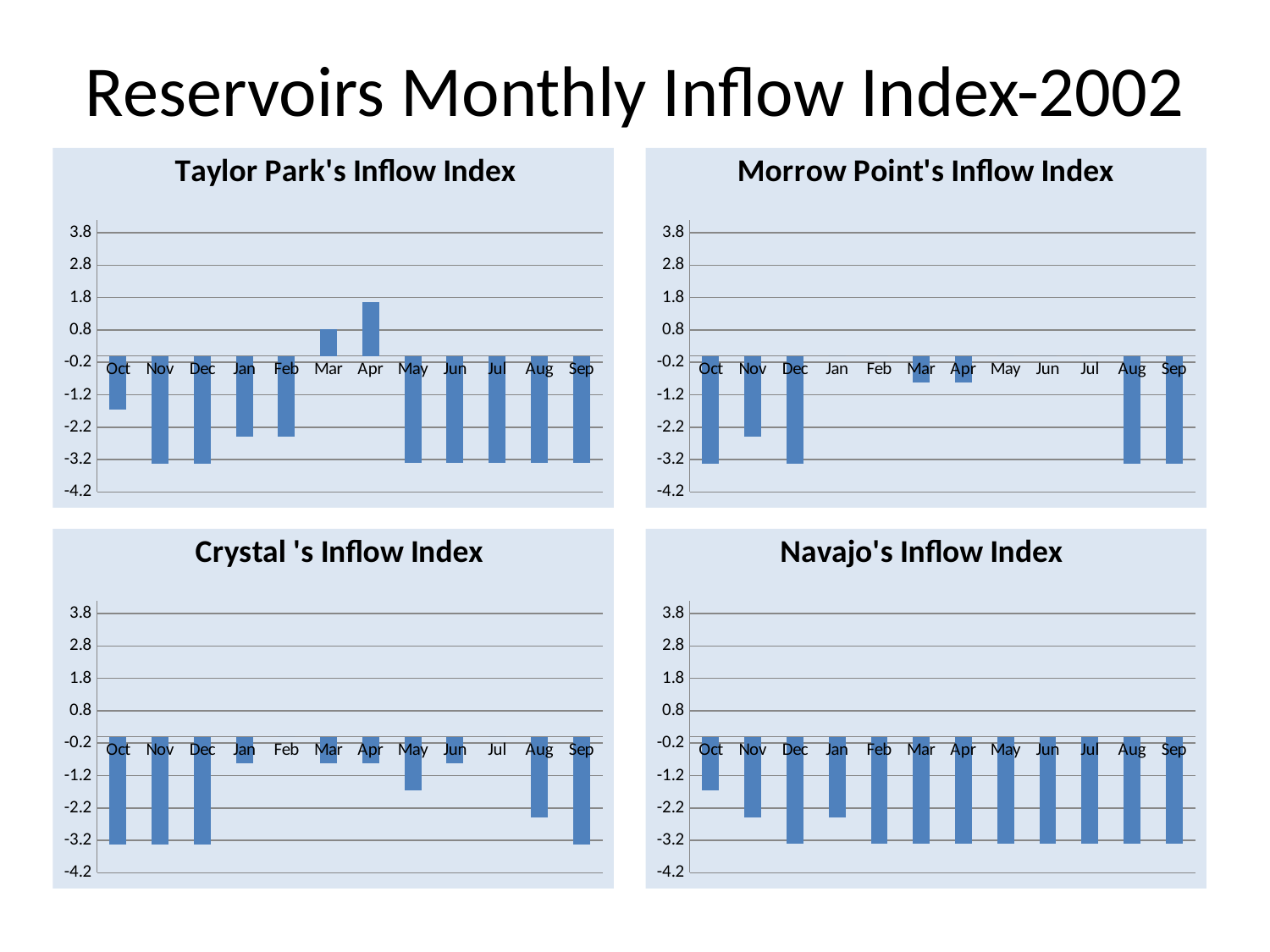
On the Crystal 's Inflow Index chart, which is larger, the value for Jan or the value for Sep? Jan On the Taylor Park's Inflow Index chart, which month has the highest value? Apr How many charts are shown on the slide? 4 On the Navajo's Inflow Index chart, which month has the highest value? Oct On the Taylor Park's Inflow Index chart, is the value for Apr greater or less than 0.8? greater How many months are plotted on the Taylor Park's Inflow Index chart? 12 On the Morrow Point's Inflow Index chart, is the value for Mar greater or less than -1.2? greater What kind of chart is the Taylor Park's Inflow Index chart? bar chart On the Taylor Park's Inflow Index chart, which is larger, the value for Mar or the value for Apr? Apr On the Morrow Point's Inflow Index chart, is the value for Nov greater or less than -3.2? greater